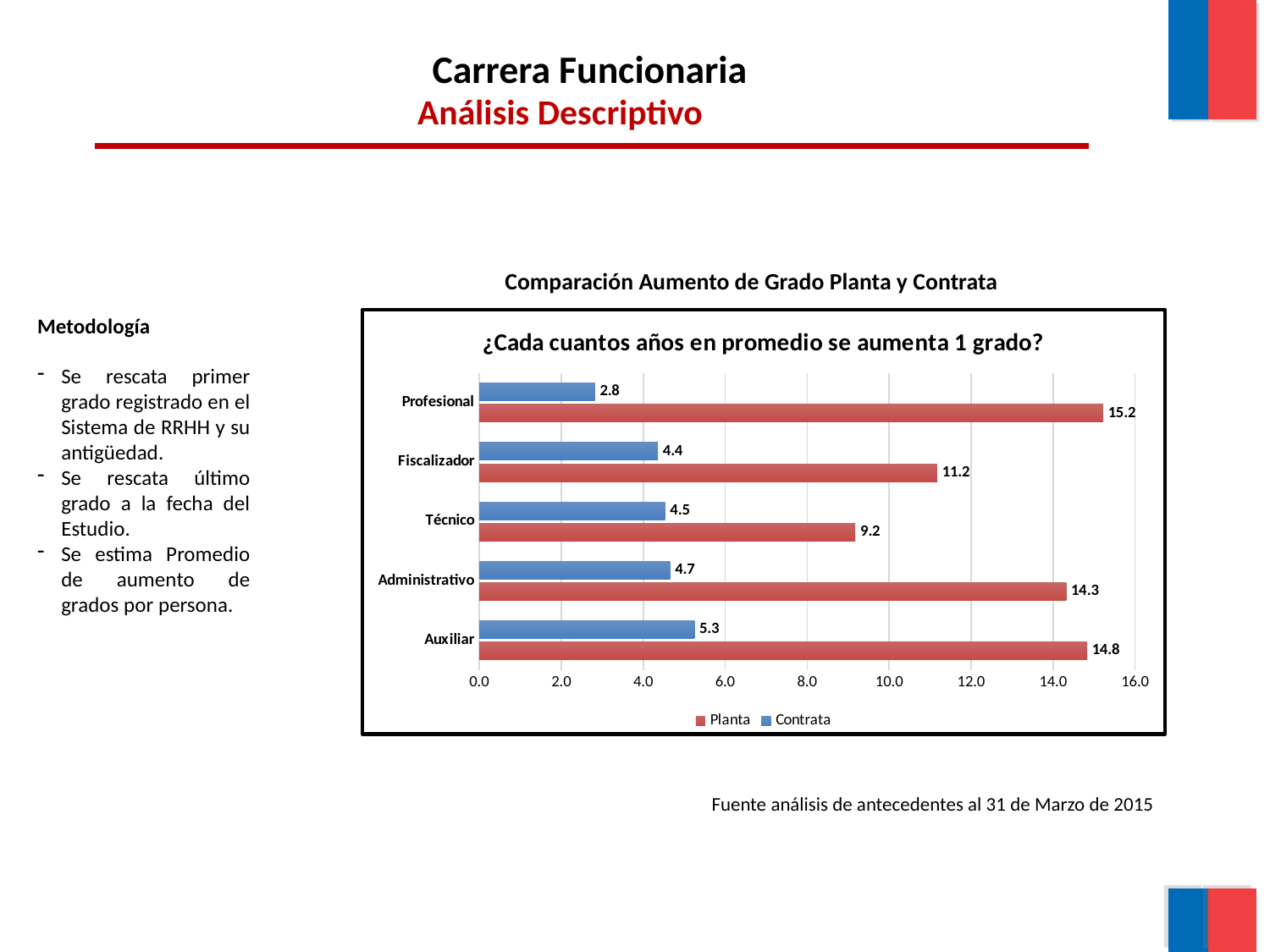
Which category has the lowest Contrata value? Profesional Which category has the highest Planta value? Profesional What kind of chart is shown on the slide? Bar chart How many series does the legend list? 2 Which is larger for Administrativo, the Planta value or the Contrata value? Planta What is the Planta value for Profesional? 15.2 What is the title shown inside the chart area? ¿Cada cuantos años en promedio se aumenta 1 grado? Is the Planta value for Auxiliar greater or less than 14.0? greater What is the Contrata value for Auxiliar? 5.3 What is the Planta value for Técnico? 9.2 How many categories are shown on the chart? 5 What is the difference between the Planta and Contrata values for Fiscalizador? 6.8